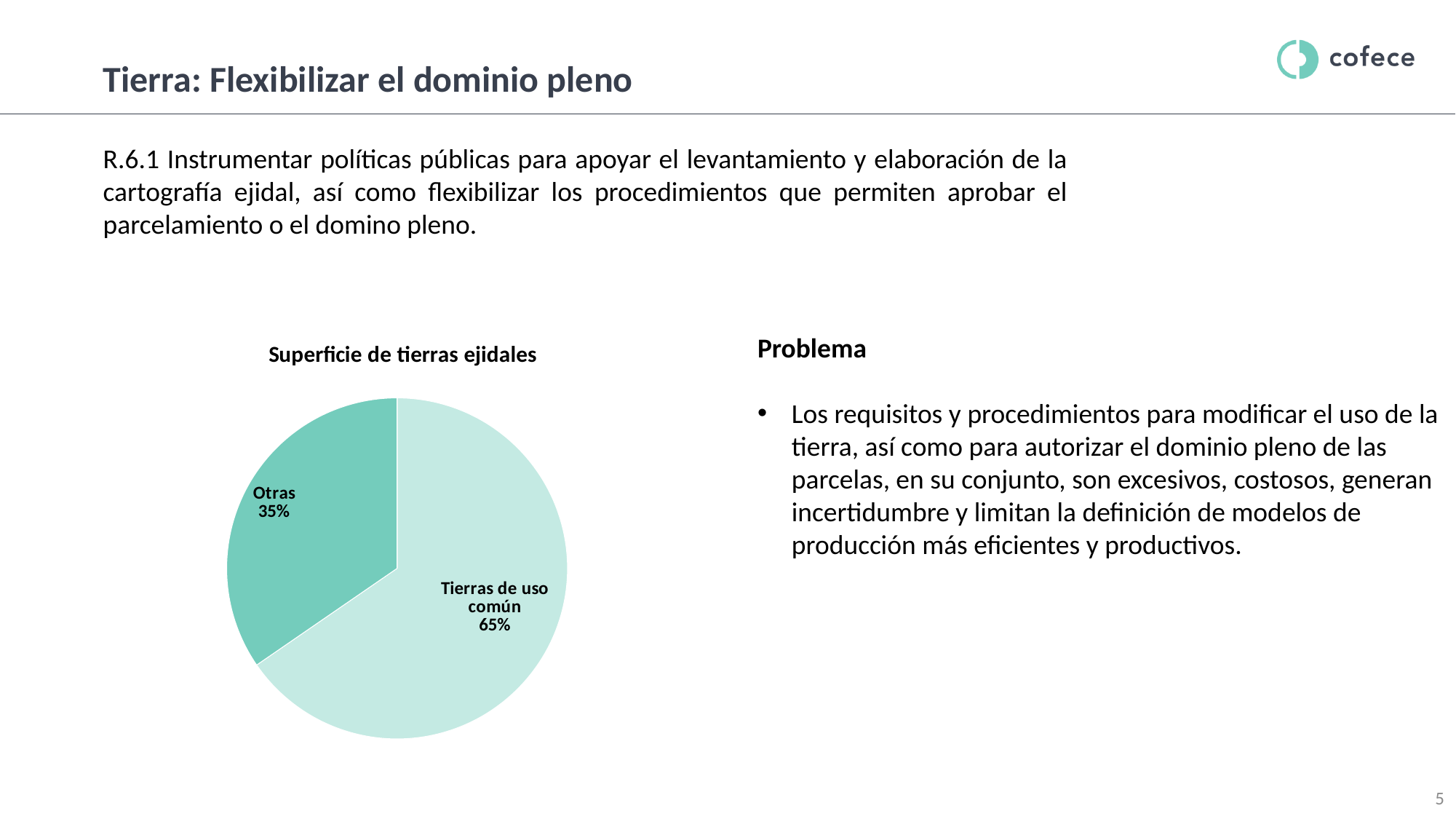
What share of the pie does 'Tierras de uso común' represent? 65% Which slice of the pie chart is the largest? Tierras de uso común What is the difference in percentage points between 'Tierras de uso común' and 'Otras'? 30 percentage points What is the title of the chart? Superficie de tierras ejidales What share of the pie does 'Otras' represent? 35% How many slices does the pie chart have? 2 Which slice of the pie chart is the smallest? Otras Which is larger, the share for 'Otras' or the share for 'Tierras de uso común'? Tierras de uso común Is the share for 'Otras' greater or less than 50%? less What kind of chart is shown on the slide? Pie chart Is the share for 'Tierras de uso común' greater or less than 50%? greater